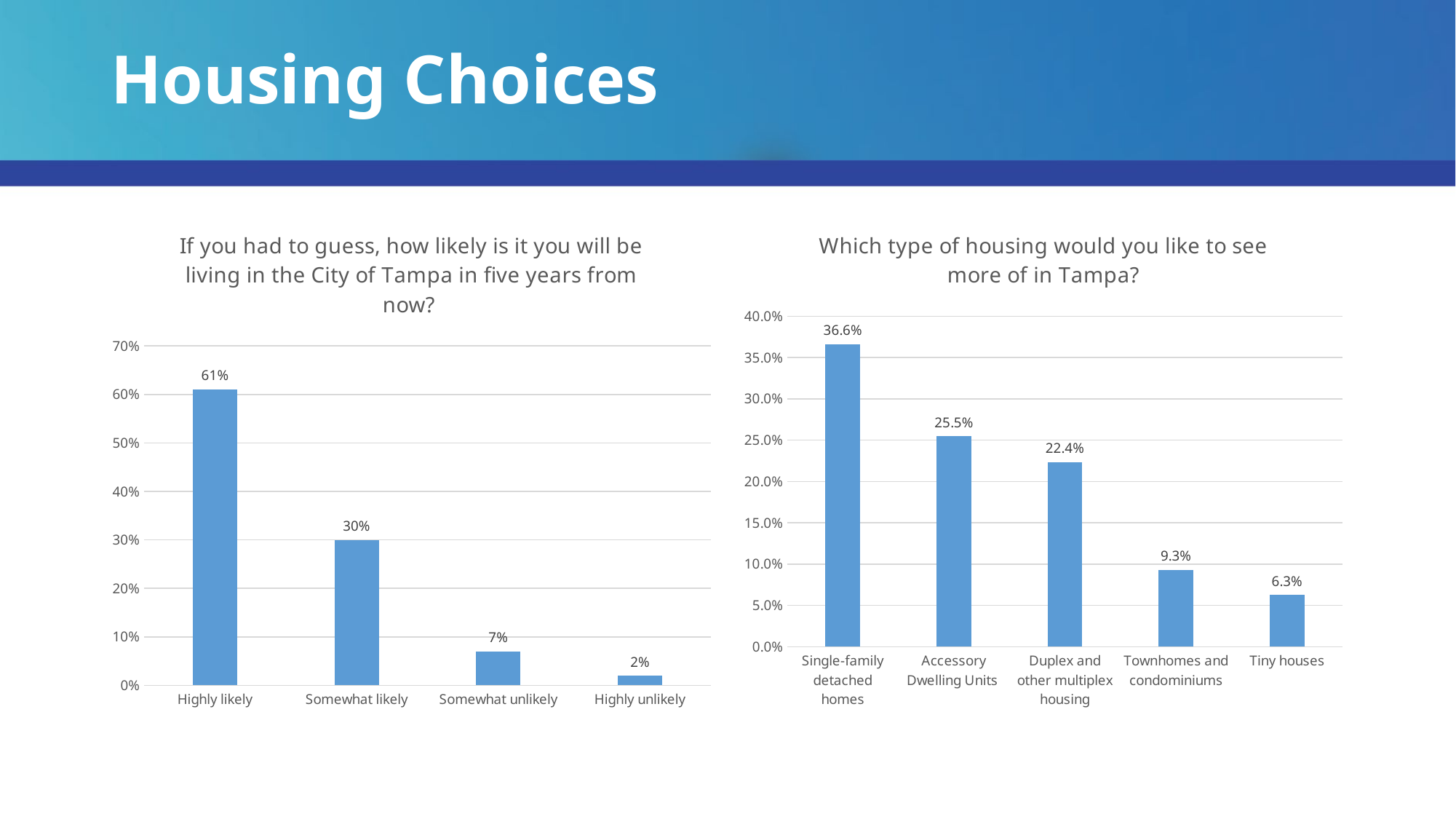
In the left chart (likelihood of living in Tampa in five years), which category has the lowest value? Highly unlikely In the right chart (type of housing to see more of in Tampa), which is larger: Duplex and other multiplex housing or Townhomes and condominiums? Duplex and other multiplex housing In the right chart (type of housing to see more of in Tampa), what is the value for Tiny houses? 6.3% In the left chart (likelihood of living in Tampa in five years), what is the difference between Highly likely and Somewhat likely? 31% In the left chart (likelihood of living in Tampa in five years), what is the value for Somewhat unlikely? 7% In the right chart (type of housing to see more of in Tampa), what is the difference between Single-family detached homes and Accessory Dwelling Units? 11.1% In the left chart (likelihood of living in Tampa in five years), how many categories are shown on the x axis? 4 What kind of chart is the right chart (type of housing to see more of in Tampa)? bar chart In the right chart (type of housing to see more of in Tampa), what is the value for Accessory Dwelling Units? 25.5% In the right chart (type of housing to see more of in Tampa), which category has the highest value? Single-family detached homes In the left chart (likelihood of living in Tampa in five years), what is the value for Highly likely? 61% In the left chart (likelihood of living in Tampa in five years), do the values rise or fall from left to right along the x axis? fall